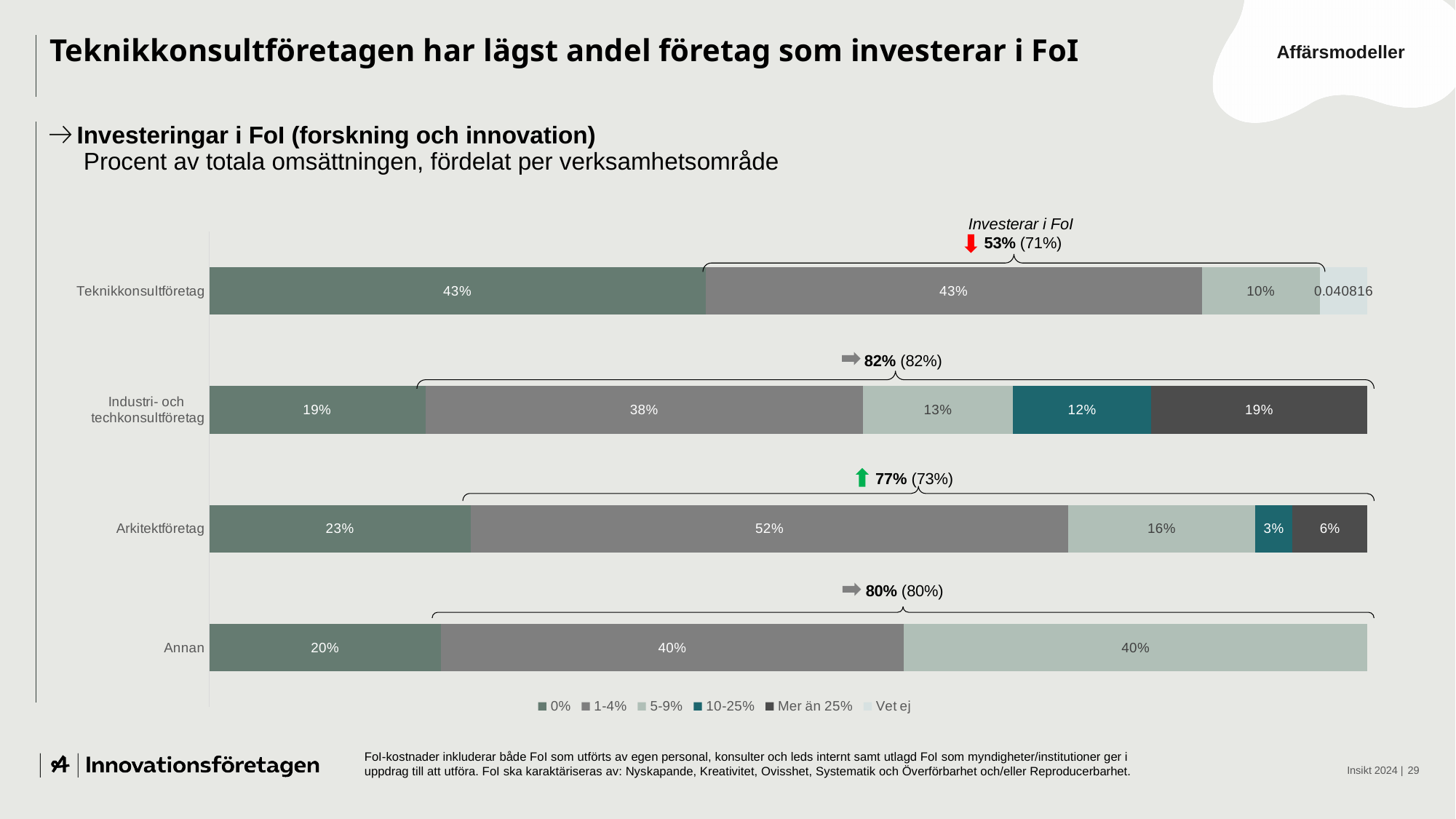
How many categories (verksamhetsområden) are plotted on the chart? 4 What is the value of the 1-4% segment for Arkitektföretag? 52% Which is larger: the 10-25% segment for Industri- och techkonsultföretag or the 10-25% segment for Arkitektföretag? Industri- och techkonsultföretag What is the value of the 5-9% segment for Annan? 40% Which category has the lowest value in the 0% segment? Industri- och techkonsultföretag What is the difference between the 1-4% segment for Arkitektföretag and the 1-4% segment for Industri- och techkonsultföretag? 14% Which category has the highest value in the 0% segment? Teknikkonsultföretag What kind of chart is shown on the slide? Stacked bar chart What is the value of the 0% segment for Industri- och techkonsultföretag? 19% According to the annotation above the bars, what share of Teknikkonsultföretag invest in FoI (Investerar i FoI)? 53% How many series does the legend list? 6 What is the value of the 'Mer än 25%' segment for Arkitektföretag? 6%